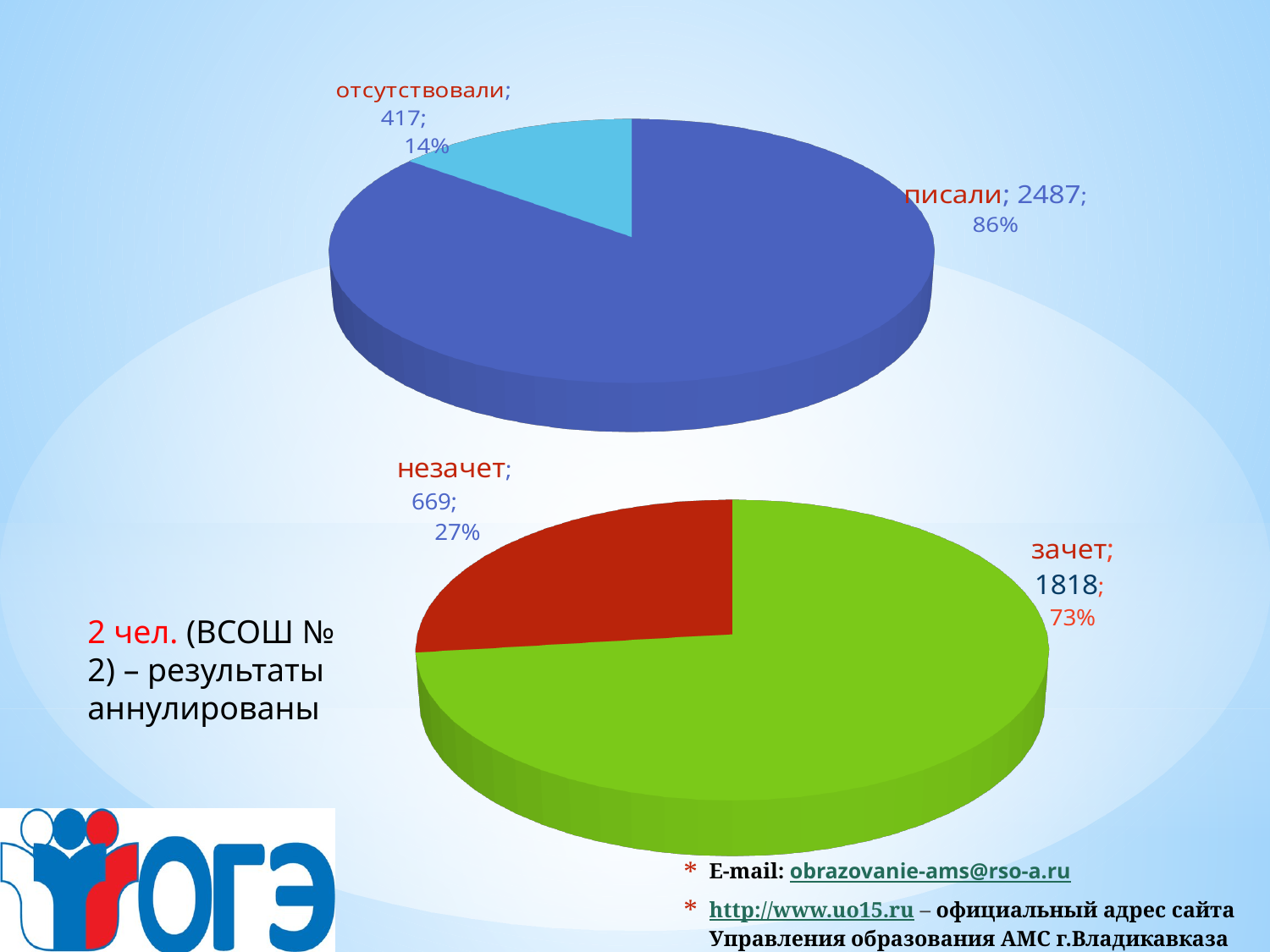
In the bottom pie chart, what is the difference between the values for "зачет" and "незачет"? 1149 In the top pie chart, which slice is the largest? писали In the top pie chart, what share of the pie does "писали" take? 86% In the top pie chart, what is the difference between the values for "писали" and "отсутствовали"? 2070 In the top pie chart, what value is shown for "писали"? 2487 In the top pie chart, what value is shown for "отсутствовали"? 417 In the top pie chart, what share of the pie does "отсутствовали" take? 14% In the bottom pie chart, what value is shown for "зачет"? 1818 In the bottom pie chart, which slice is the smallest? незачет In the bottom pie chart, what share of the pie does "незачет" take? 27% What type of chart is the bottom chart on the slide? Pie chart In the bottom pie chart, what value is shown for "незачет"? 669